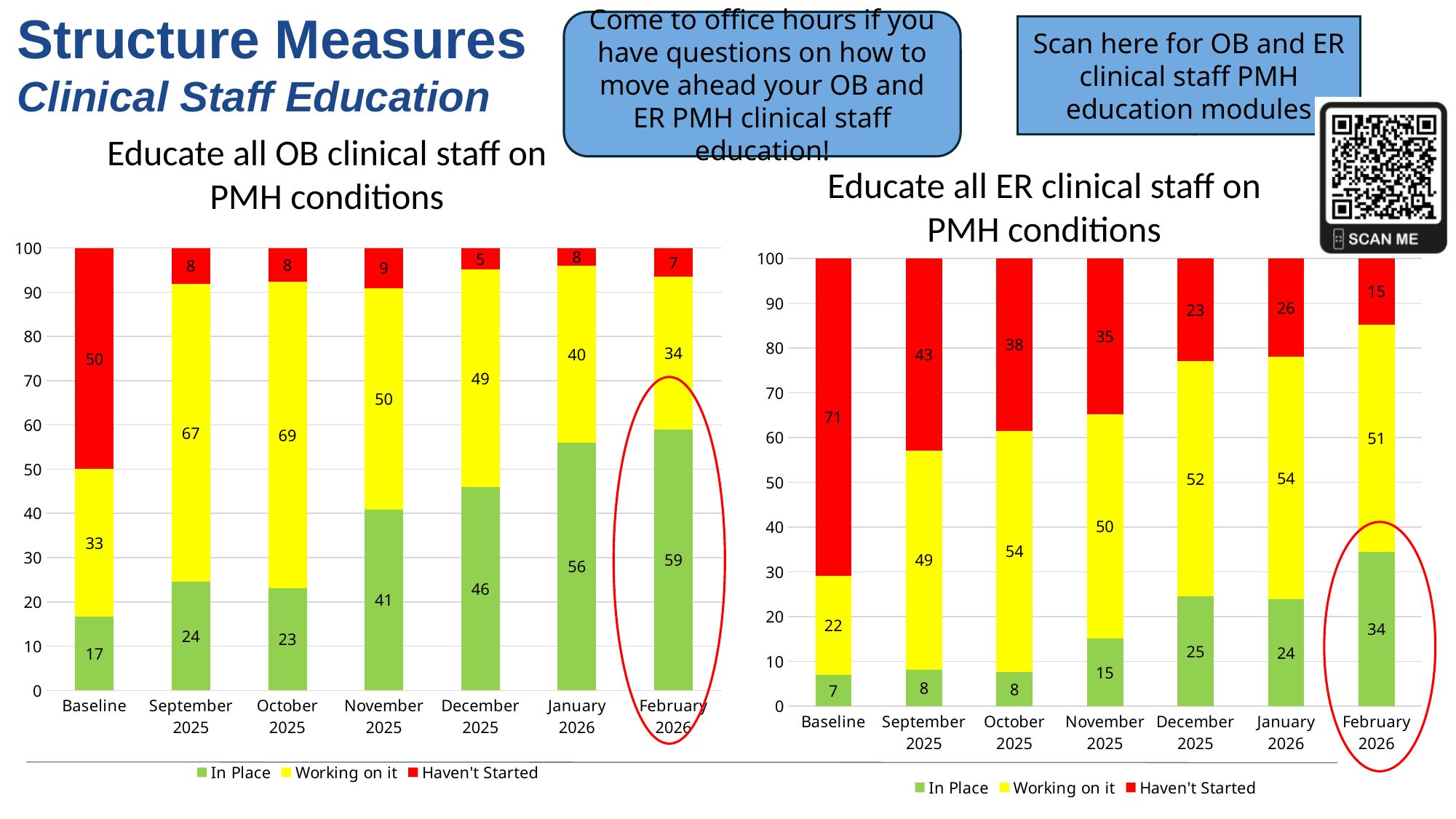
How many categories are shown on the x axis of the 'Educate all OB clinical staff on PMH conditions' chart? 7 In the 'Educate all OB clinical staff on PMH conditions' chart, what is the In Place value for February 2026? 59 In the 'Educate all ER clinical staff on PMH conditions' chart, which category has the lowest In Place value? Baseline In the 'Educate all ER clinical staff on PMH conditions' chart, which is larger: the Working on it value for January 2026 or for December 2025? January 2026 What kind of chart is the 'Educate all OB clinical staff on PMH conditions' chart? Stacked bar chart In the 'Educate all OB clinical staff on PMH conditions' chart, which colour represents the Haven't Started series? Red In the 'Educate all ER clinical staff on PMH conditions' chart, does the Haven't Started value rise or fall from Baseline to February 2026? Fall In the 'Educate all OB clinical staff on PMH conditions' chart, what is the difference between the Working on it values for October 2025 and February 2026? 35 In the 'Educate all ER clinical staff on PMH conditions' chart, what is the difference between the Haven't Started values for September 2025 and February 2026? 28 In the 'Educate all ER clinical staff on PMH conditions' chart, what is the Haven't Started value for Baseline? 71 How many series does the legend of the 'Educate all ER clinical staff on PMH conditions' chart list? 3 In the 'Educate all OB clinical staff on PMH conditions' chart, which category has the highest In Place value? February 2026